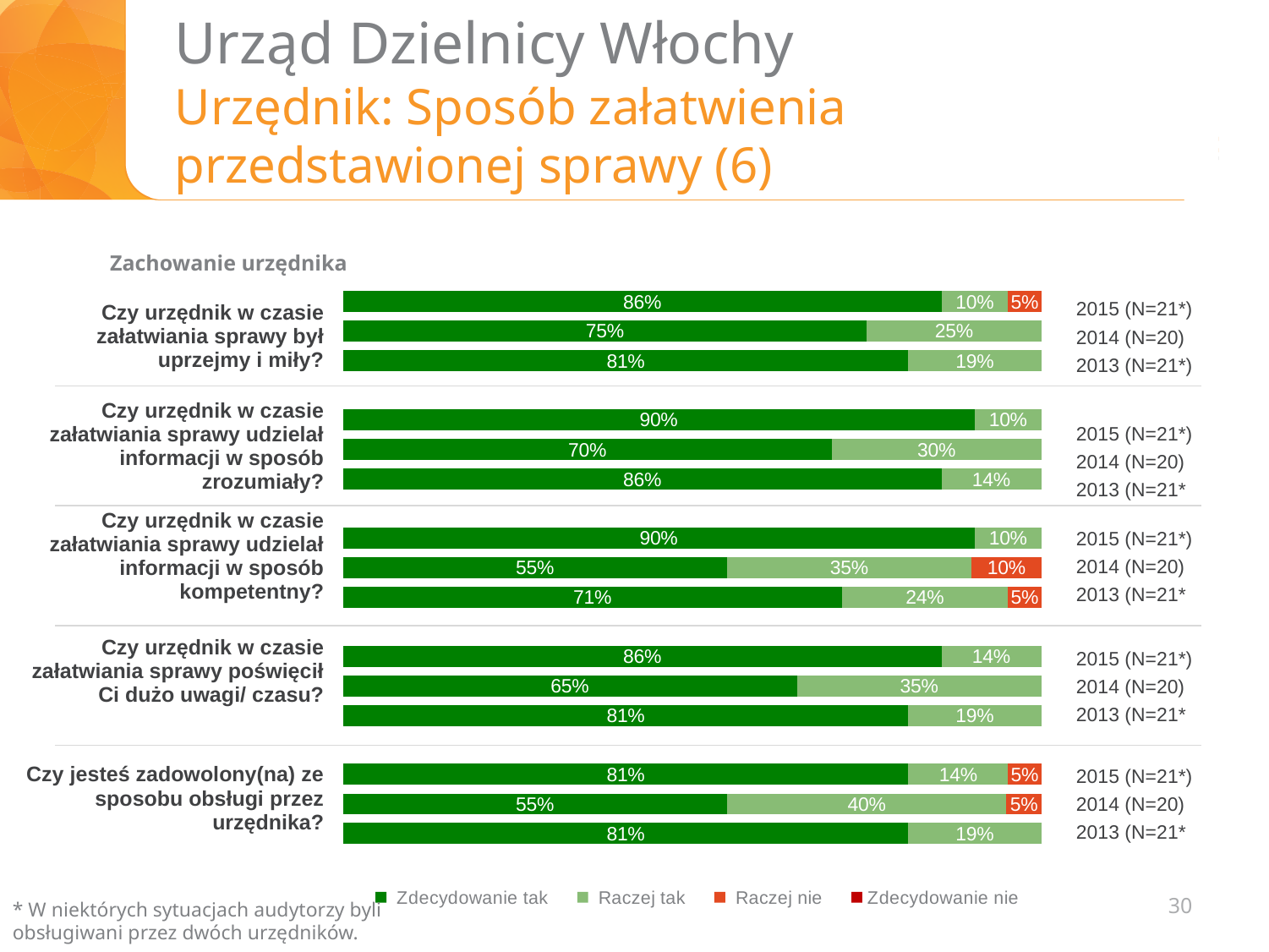
What is the 'Raczej nie' value for 2014 for the question 'Czy urzędnik w czasie załatwiania sprawy udzielał informacji w sposób kompetentny?' 10% What is the 'Zdecydowanie tak' value for 2015 for the question 'Czy urzędnik w czasie załatwiania sprawy był uprzejmy i miły?' 86% How many survey questions (categories) are shown in the chart? 5 For the question 'Czy jesteś zadowolony(na) ze sposobu obsługi przez urzędnika?', which year has the lowest 'Zdecydowanie tak' value? 2014 (N=20) What is the total of the 'Zdecydowanie tak' and 'Raczej tak' segments for 2015 for the question 'Czy jesteś zadowolony(na) ze sposobu obsługi przez urzędnika?' 95% Which is larger: the 'Zdecydowanie tak' value for 2013 or for 2014 for the question 'Czy urzędnik w czasie załatwiania sprawy był uprzejmy i miły?' 2013 What is the sample size shown for 2014? N=20 What type of chart is shown on the slide? stacked bar chart What is the 'Raczej tak' value for 2014 for the question 'Czy urzędnik w czasie załatwiania sprawy udzielał informacji w sposób zrozumiały?' 30% How many series does the legend list? 4 What is the difference between the 'Zdecydowanie tak' values for 2015 and 2014 for the question 'Czy urzędnik w czasie załatwiania sprawy udzielał informacji w sposób kompetentny?' 35 percentage points For the question 'Czy urzędnik w czasie załatwiania sprawy poświęcił Ci dużo uwagi/ czasu?', which year has the highest 'Zdecydowanie tak' value? 2015 (N=21*)